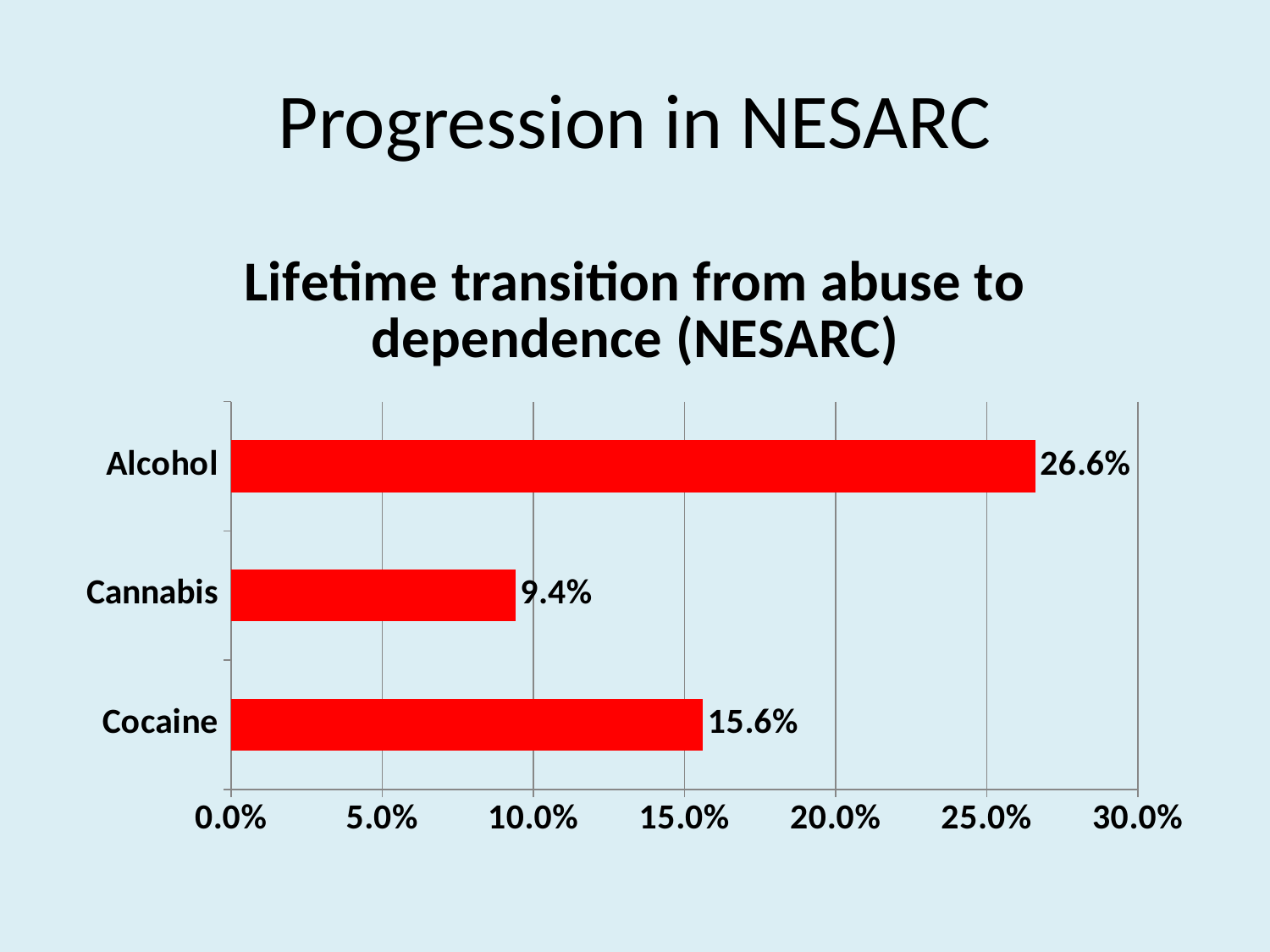
What is the difference between the values for Cocaine and Cannabis? 6.2% Is the value for Alcohol greater or less than 25.0%? greater What is the difference between the values for Alcohol and Cocaine? 11.0% What is the title of the chart? Lifetime transition from abuse to dependence (NESARC) Which category has the lowest value? Cannabis Which category has the highest value? Alcohol How many categories are shown in the chart? 3 What is the value for Cocaine? 15.6% Which is larger, the value for Cannabis or the value for Cocaine? Cocaine What is the value for Cannabis? 9.4% What is the value for Alcohol? 26.6% What kind of chart is shown on the slide? Bar chart